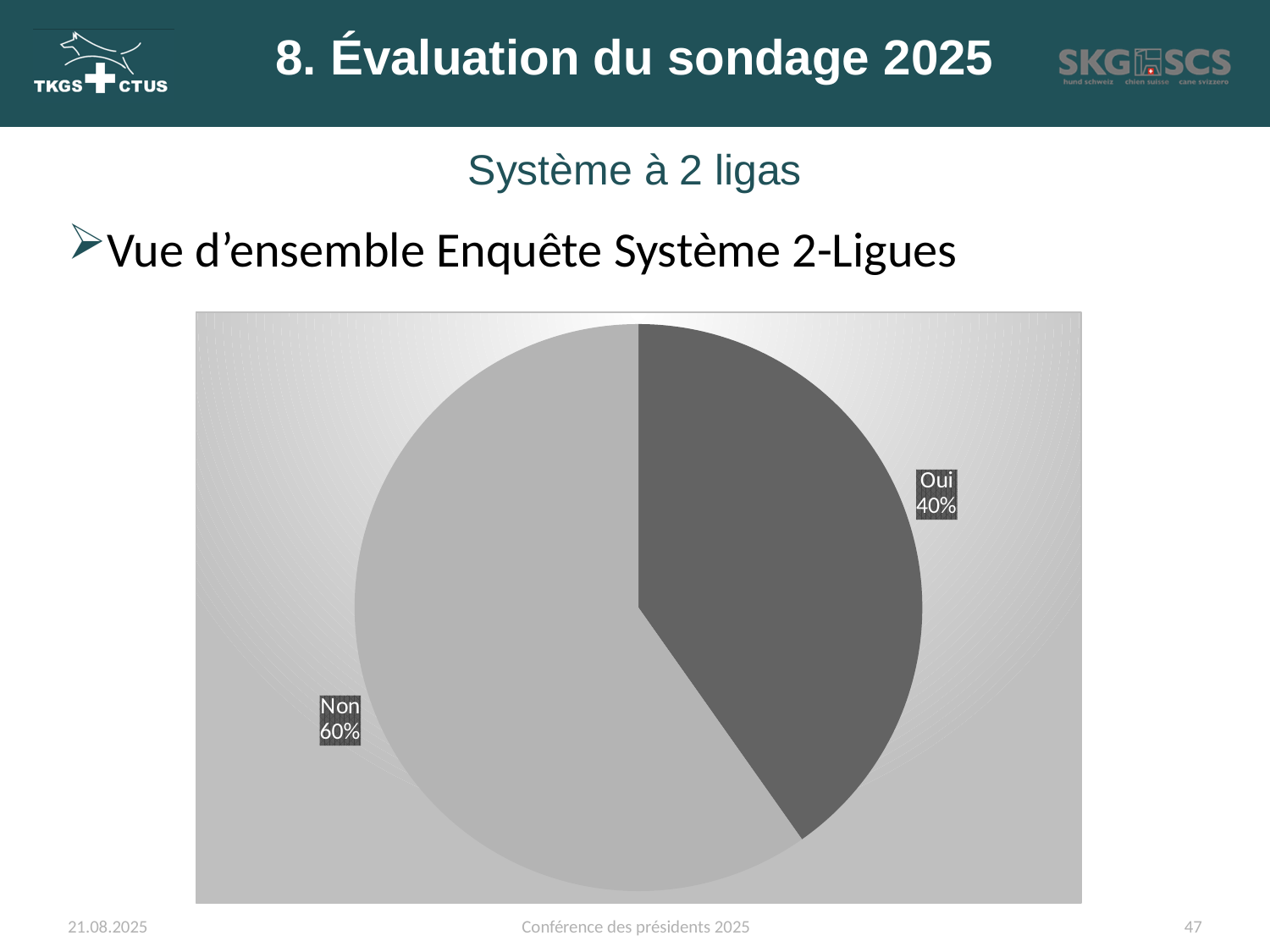
What share of the pie does the "Non" slice represent? 60% What kind of chart is shown on the slide? pie chart Which slice of the pie is the largest? Non Which slice of the pie is the smallest? Oui Which slice of the pie is shown in the darker grey colour? Oui What share of the pie does the "Oui" slice represent? 40% What is the subtitle shown above the chart on the slide? Système à 2 ligas Which is larger, the "Oui" slice or the "Non" slice? Non What is the difference in percentage points between the "Non" and "Oui" slices? 20 percentage points How many slices does the pie chart have? 2